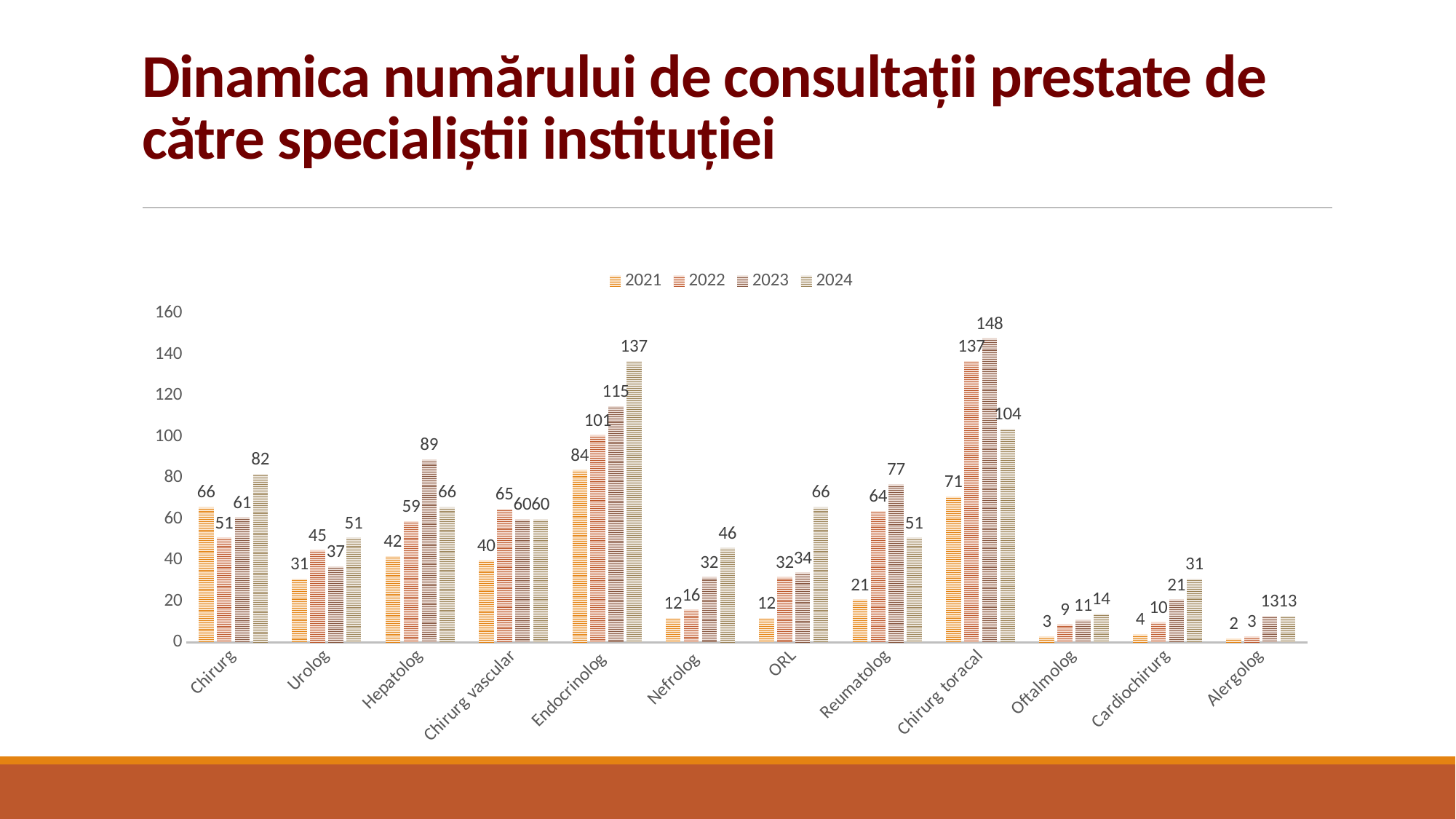
Is the value for Endocrinolog in 2023 greater or less than 100? greater How many specialist categories are shown on the x axis? 12 What is the value for Endocrinolog in 2024? 137 Which category has the highest value in the 2023 series? Chirurg toracal How many series does the legend list? 4 Do the values for Cardiochirurg rise or fall from 2021 to 2024? rise What is the difference between the 2024 and 2021 values for Chirurg? 16 What is the value for Reumatolog in 2021? 21 Which is larger for Chirurg toracal: the 2022 value or the 2024 value? 2022 What is the value for Hepatolog in 2023? 89 What kind of chart is shown on the slide? bar chart Which category has the lowest value in the 2021 series? Alergolog